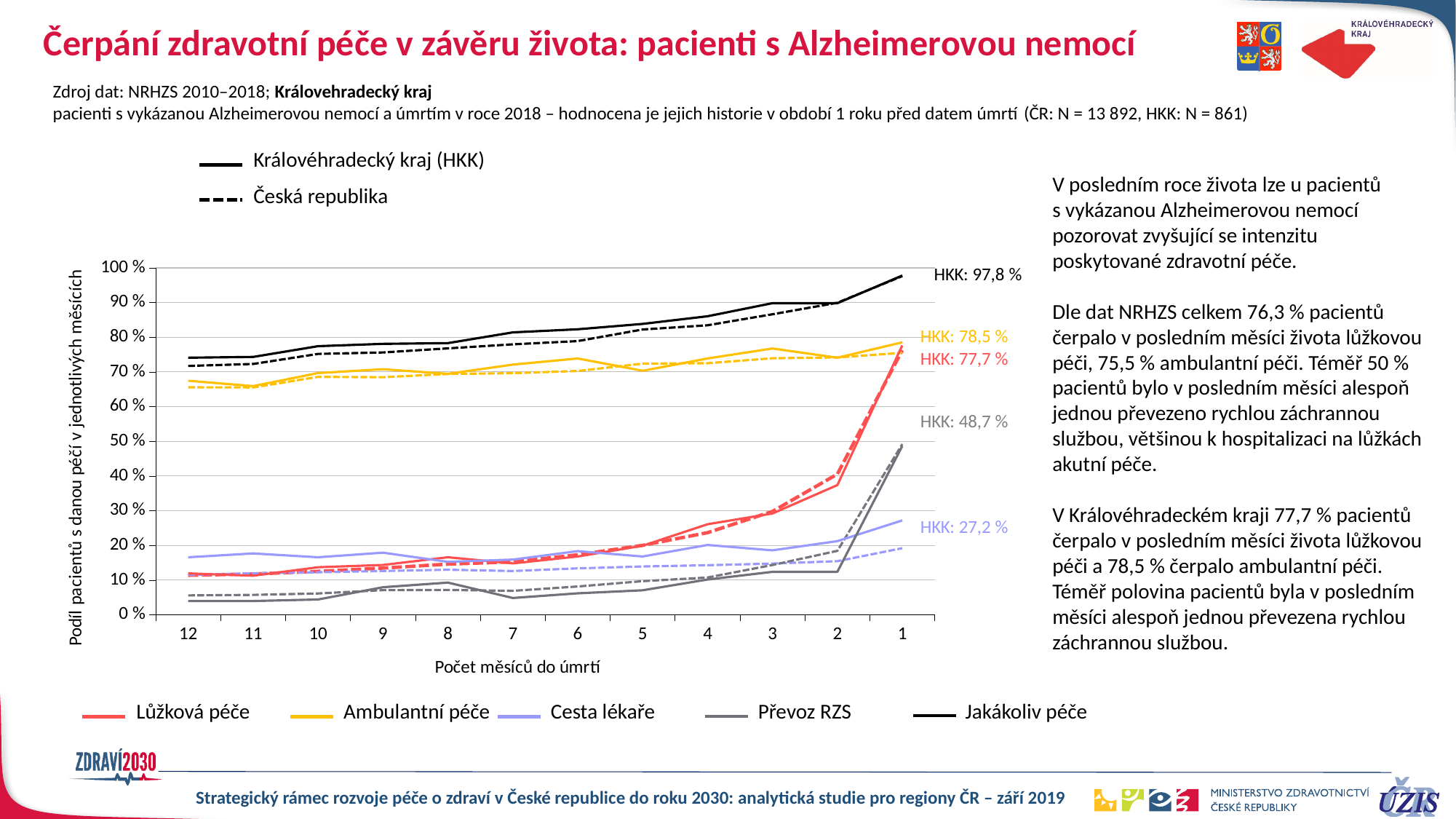
What is the labelled HKK value for Ambulantní péče at 1 month before death? 78,5 % Which type of care has the lowest labelled HKK value at 1 month before death? Cesta lékaře What kind of chart is shown on the slide? line chart What is the labelled HKK value for Lůžková péče at 1 month before death? 77,7 % Is the HKK value for Převoz RZS at 12 months before death greater or less than 10 %? less How many months (points) are shown along the x axis? 12 What is the difference between the labelled HKK values for Jakákoliv péče and Převoz RZS at 1 month before death? 49,1 % Which line style represents Česká republika in the chart? dashed What is the labelled HKK value for Převoz RZS at 1 month before death? 48,7 % Which type of care has the highest labelled HKK value at 1 month before death? Jakákoliv péče What is the labelled HKK value for Cesta lékaře at 1 month before death? 27,2 % What is the labelled HKK value for Jakákoliv péče at 1 month before death? 97,8 %